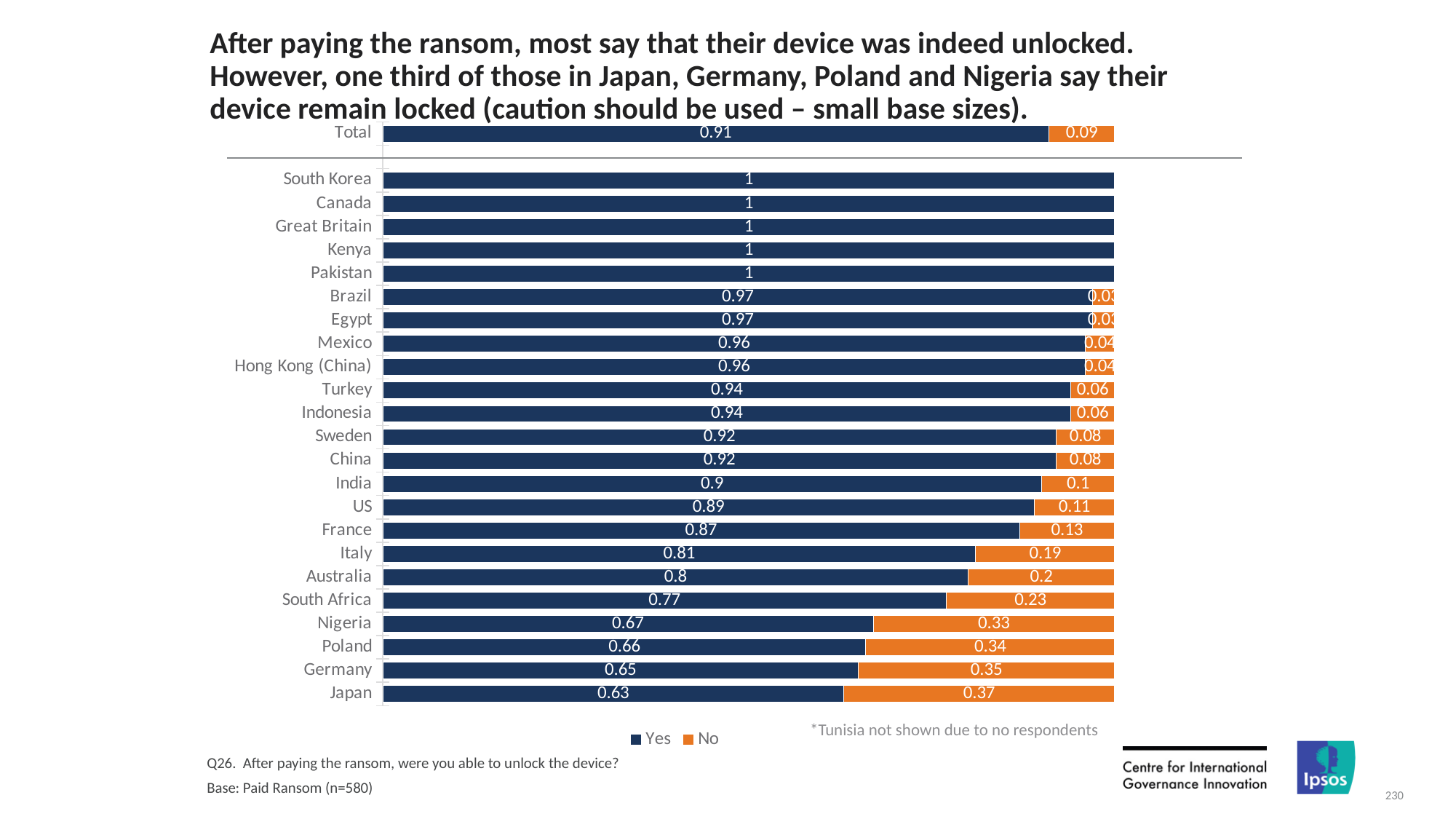
What is the Yes value for the Total bar? 0.91 What is the difference between the No value for Poland and the No value for Italy? 0.15 What is the Yes value for Japan? 0.63 What is the total of the stacked bar for France? 1 Which has the larger Yes value, Australia or South Africa? Australia What is the No value for Germany? 0.35 What is the No value for India? 0.1 What kind of chart is shown on the slide? Stacked bar chart How many series does the legend list? 2 Which country has the lowest Yes value? Japan How many countries are listed below the Total bar? 23 Which country has the highest No value? Japan